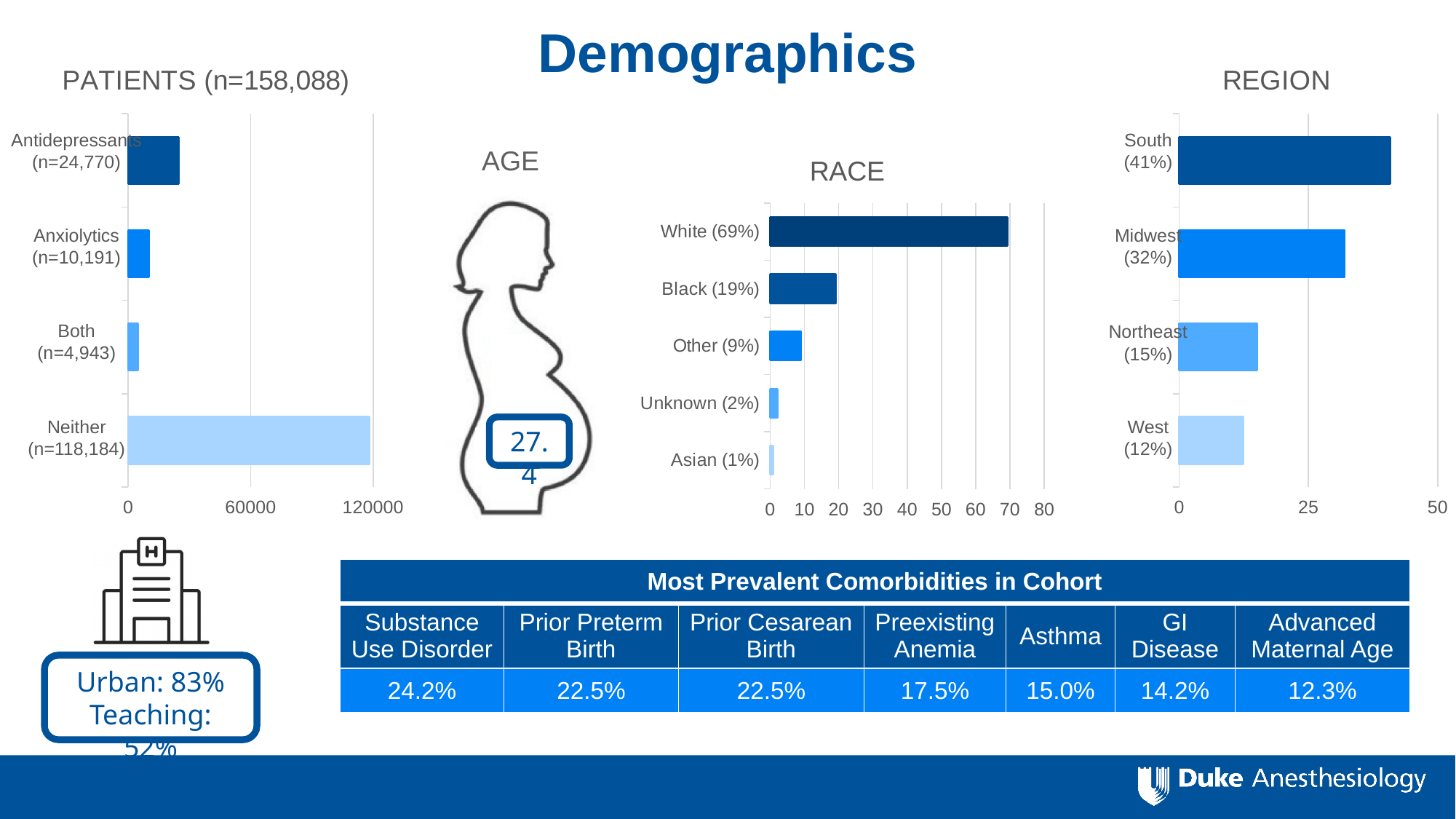
In the RACE chart, which category has the lowest value? Asian In the REGION chart, what percentage is shown for Midwest? 32% In the PATIENTS (n=158,088) chart, what is the difference between the Antidepressants and Anxiolytics values? 14,579 In the PATIENTS (n=158,088) chart, what is the value for Anxiolytics? n=10,191 In the REGION chart, which is larger, Northeast or West? Northeast In the REGION chart, what is the difference between the South and Midwest percentages? 9% In the PATIENTS (n=158,088) chart, which category has the highest value? Neither How many categories are shown in the RACE chart? 5 How many categories are shown in the PATIENTS (n=158,088) chart? 4 In the PATIENTS (n=158,088) chart, is the value for Neither greater or less than 60000? greater What type of chart is the RACE chart? bar chart In the RACE chart, what percentage is shown for Black? 19%